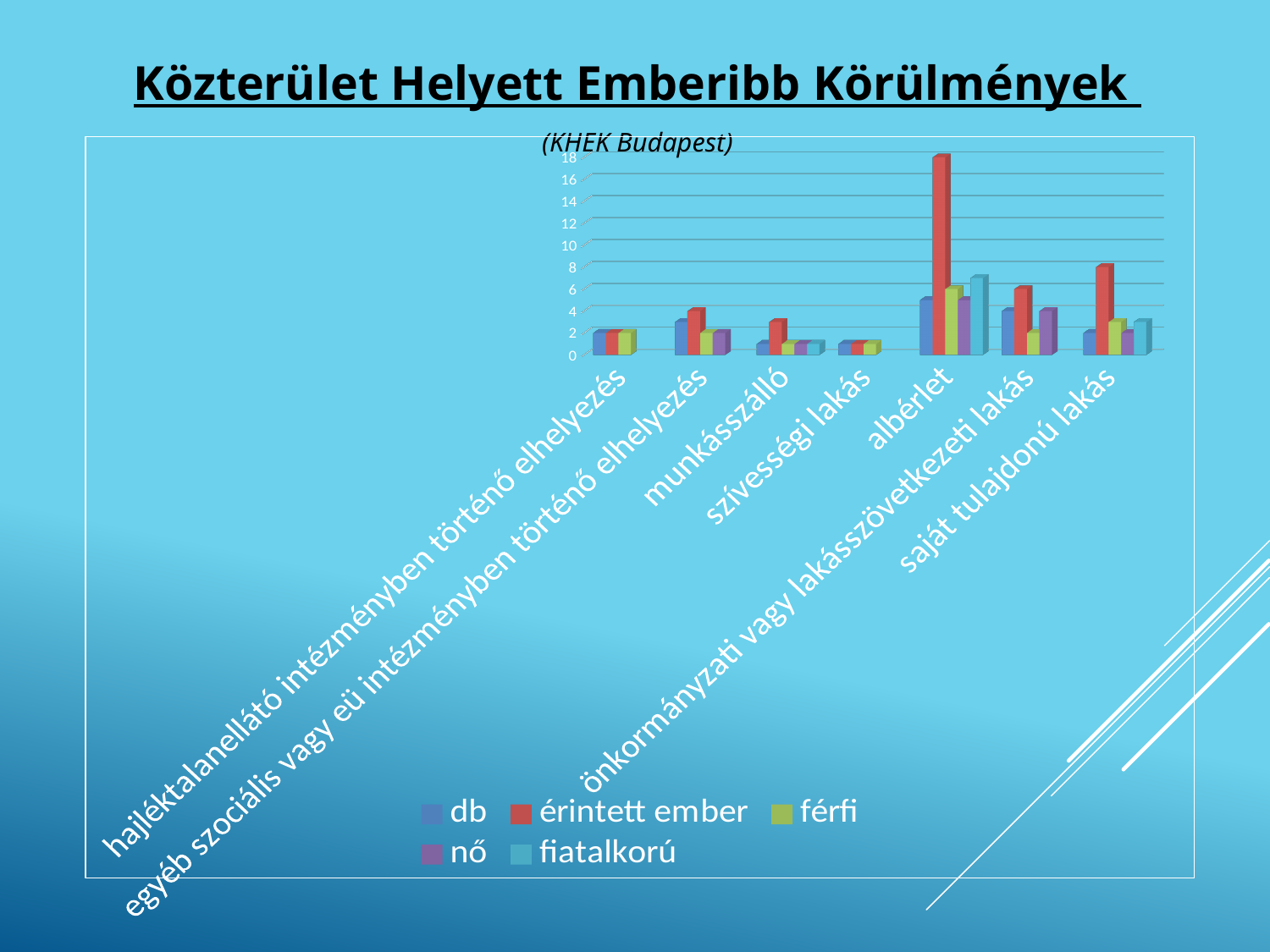
Which has the larger 'érintett ember' value: albérlet or saját tulajdonú lakás? albérlet What kind of chart is shown on the slide? bar chart Which series is shown in red in the chart's legend? érintett ember Is the 'érintett ember' value for önkormányzati vagy lakásszövetkezeti lakás greater or less than 10? less How many series does the chart's legend list? 5 Which has the larger 'db' value: albérlet or munkásszálló? albérlet Is the 'érintett ember' value for munkásszálló greater or less than 6? less Which category has the highest value for the 'érintett ember' series? albérlet Is the 'érintett ember' value for albérlet greater or less than 14? greater How many categories are shown on the x axis of the chart? 7